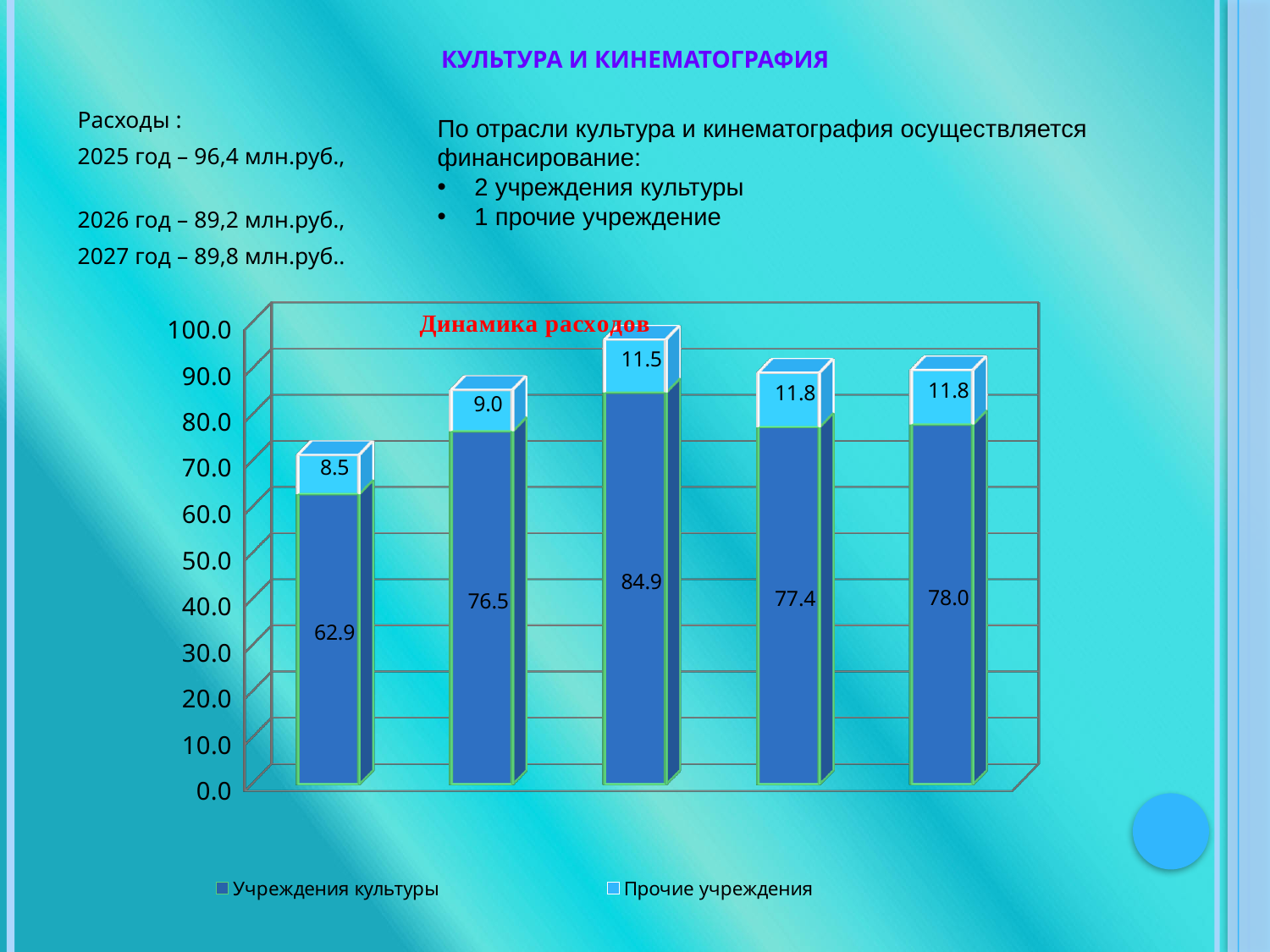
Which series in the "Динамика расходов" chart is shown in light blue? Прочие учреждения In the "Динамика расходов" chart, what is the total of the first stacked bar from the left? 71.4 In the "Динамика расходов" chart, what is the difference between the "Учреждения культуры" values of the third and first bars from the left? 22.0 In the "Динамика расходов" chart, what is the total of the third stacked bar from the left? 96.4 In the "Динамика расходов" chart, is the "Учреждения культуры" value of the second bar from the left larger or smaller than that of the fifth bar? Smaller In the "Динамика расходов" chart, what is the value of "Прочие учреждения" for the third bar from the left? 11.5 How many stacked bars are plotted in the "Динамика расходов" chart? 5 In the "Динамика расходов" chart, which bar has the lowest "Прочие учреждения" value? The first bar from the left (8.5) How many series does the legend of the "Динамика расходов" chart list? 2 In the "Динамика расходов" chart, what is the value of "Учреждения культуры" for the first bar from the left? 62.9 What kind of chart is shown under the title "Динамика расходов"? Stacked bar chart In the "Динамика расходов" chart, which bar has the highest "Учреждения культуры" value? The third bar from the left (84.9)